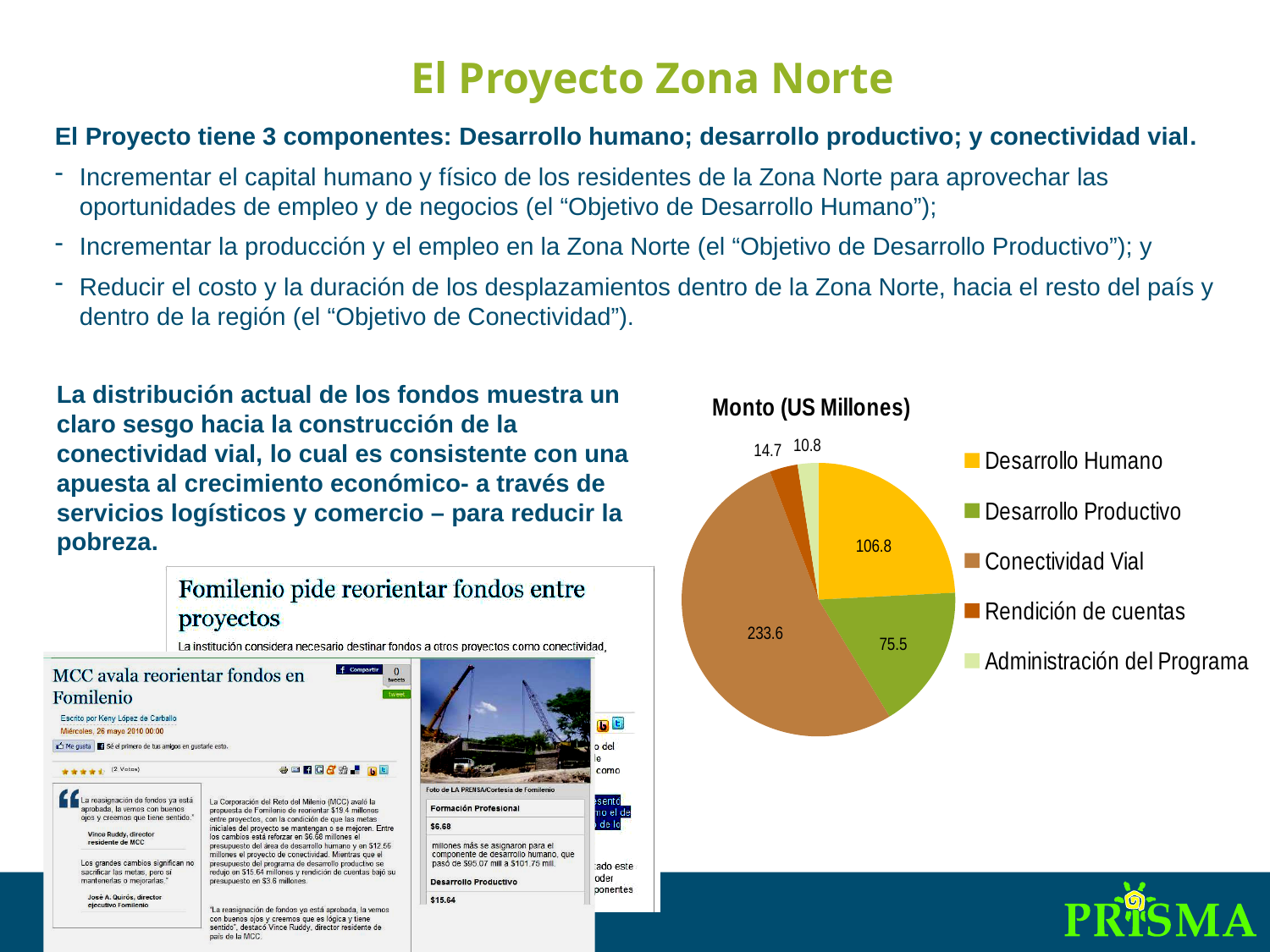
Which component has the largest amount in the pie chart? Conectividad Vial What is the title of the chart? Monto (US Millones) What is the value for Rendición de cuentas in the pie chart? 14.7 What is the value for Conectividad Vial in the pie chart? 233.6 How many slices does the pie chart have? 5 Which component has the smallest amount in the pie chart? Administración del Programa Which is larger, the value for Desarrollo Humano or the value for Desarrollo Productivo? Desarrollo Humano What is the difference between the values for Conectividad Vial and Desarrollo Humano? 126.8 What type of chart is shown on the slide? pie chart What is the value for Administración del Programa in the pie chart? 10.8 What is the value for Desarrollo Productivo in the pie chart? 75.5 What is the value for Desarrollo Humano in the pie chart? 106.8